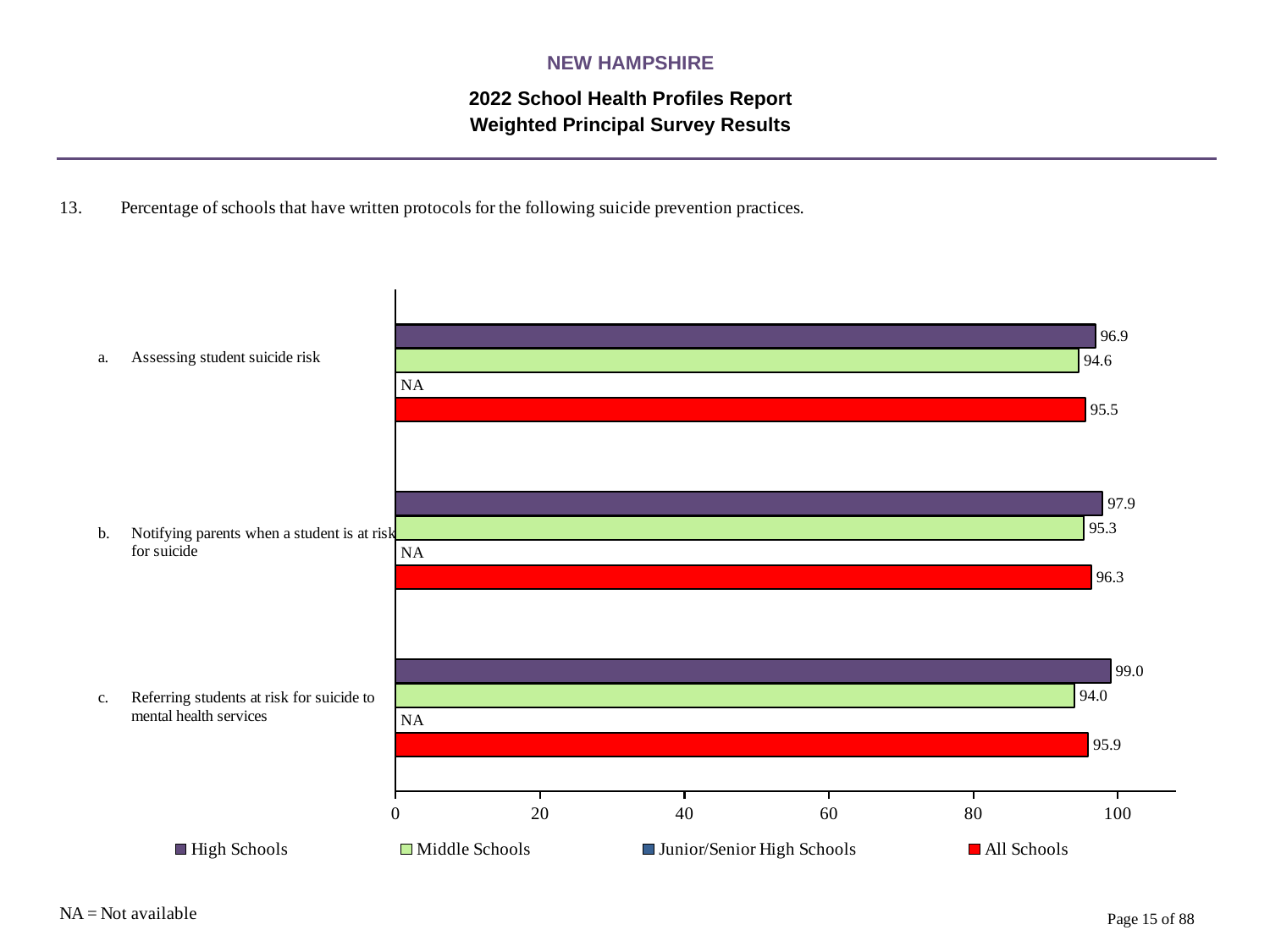
What is shown for Junior/Senior High Schools for 'Assessing student suicide risk'? NA What kind of chart is shown on the slide? Bar chart What does NA stand for according to the note on the slide? Not available Which practice has the lowest Middle Schools value? Referring students at risk for suicide to mental health services What is the value for Middle Schools for 'Assessing student suicide risk'? 94.6 What is the value for High Schools for 'Referring students at risk for suicide to mental health services'? 99.0 How many suicide prevention practices are listed on the chart? 3 Which practice has the highest High Schools value? Referring students at risk for suicide to mental health services What is the value for All Schools for 'Notifying parents when a student is at risk for suicide'? 96.3 What is the difference between the High Schools and Middle Schools values for 'Referring students at risk for suicide to mental health services'? 5.0 Which is larger for 'Assessing student suicide risk': the High Schools value or the All Schools value? High Schools How many series does the legend list? 4